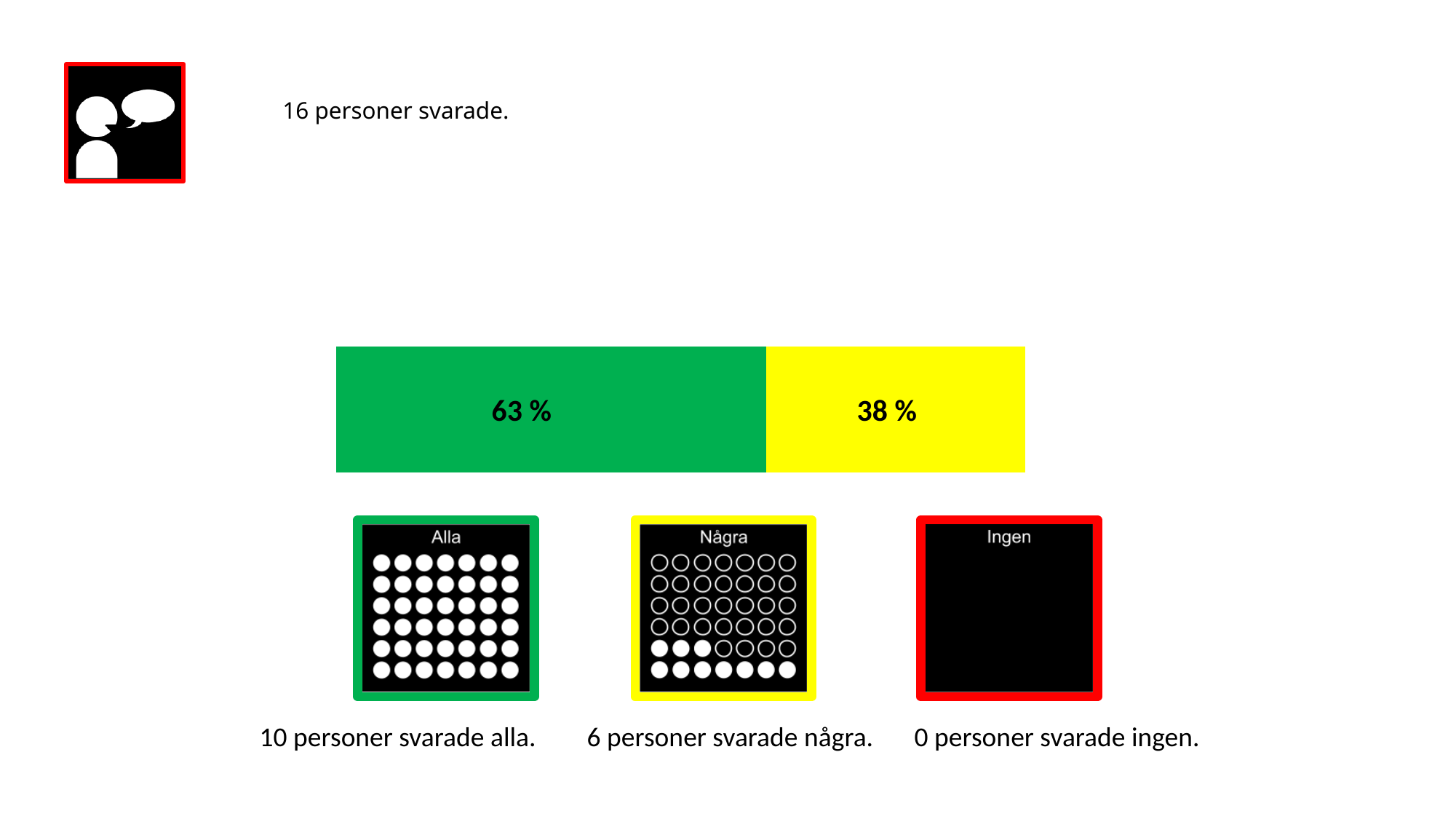
What is the difference between the green segment value and the yellow segment value? 25 % Which segment of the stacked bar is the largest? The green segment (63 %) According to the pictogram boxes, how many people answered 'Alla'? 10 What kind of chart is shown in the middle of the slide? A stacked horizontal bar chart According to the pictogram boxes, how many people answered 'Några'? 6 According to the pictogram boxes, how many people answered 'Ingen'? 0 What percentage is printed on the yellow segment of the stacked bar? 38 % What colour is the larger segment of the stacked bar? Green How many segments does the stacked bar have? 2 Which segment of the stacked bar is the smallest? The yellow segment (38 %) Which is larger, the green segment or the yellow segment of the bar? The green segment What percentage is printed on the green segment of the stacked bar? 63 %